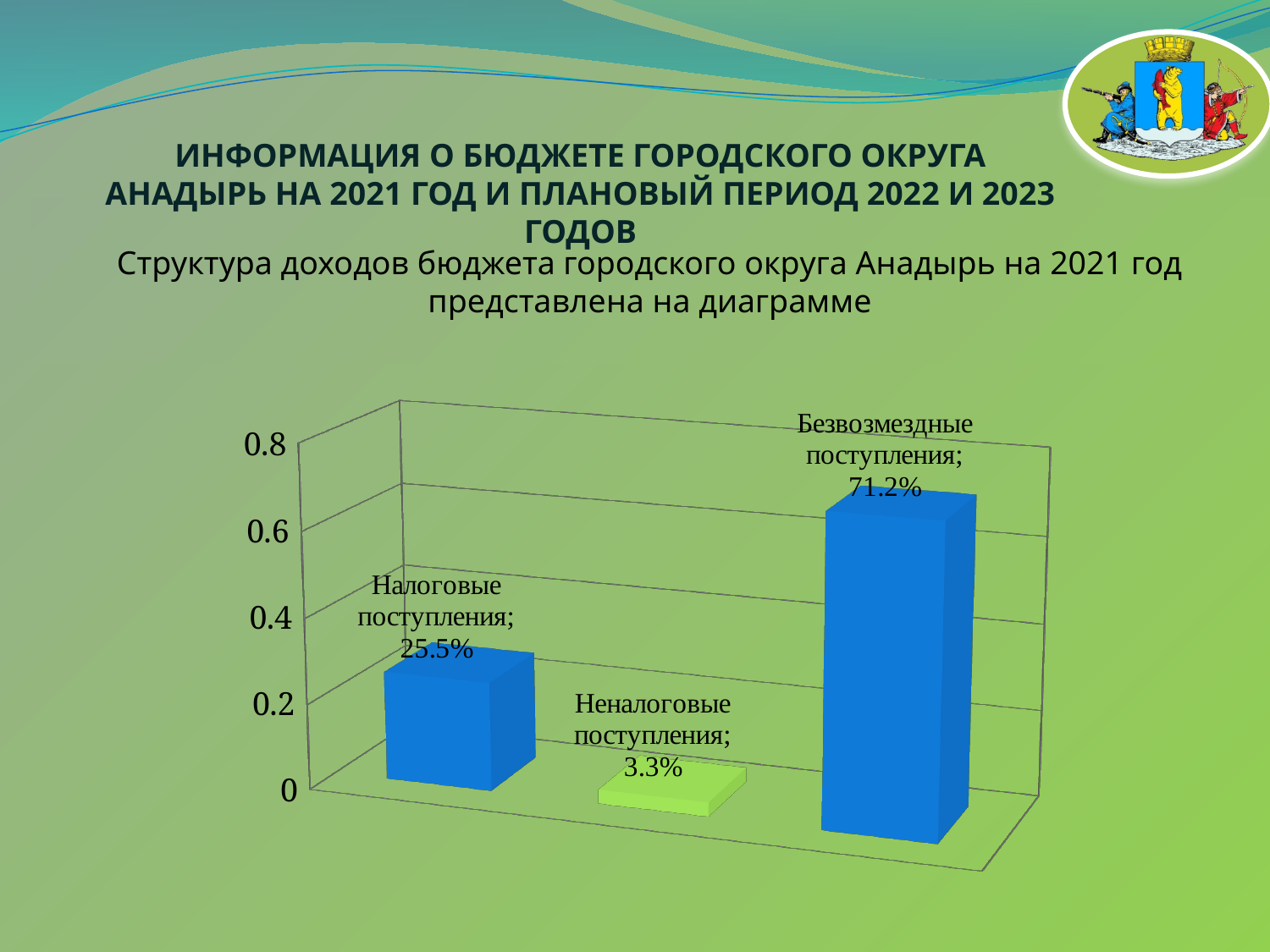
How many categories are shown in the chart? 3 Which category has the highest value? Безвозмездные поступления Is the value for Безвозмездные поступления greater or less than 0.6? greater What is the value for Безвозмездные поступления? 71.2% What is the value for Налоговые поступления? 25.5% What is the value for Неналоговые поступления? 3.3% What is the difference between Безвозмездные поступления and Налоговые поступления? 45.7% What colour is the bar for Неналоговые поступления? green What is the difference between Налоговые поступления and Неналоговые поступления? 22.2% Which category has the lowest value? Неналоговые поступления What kind of chart is shown on the slide? bar chart Which is larger, Налоговые поступления or Неналоговые поступления? Налоговые поступления